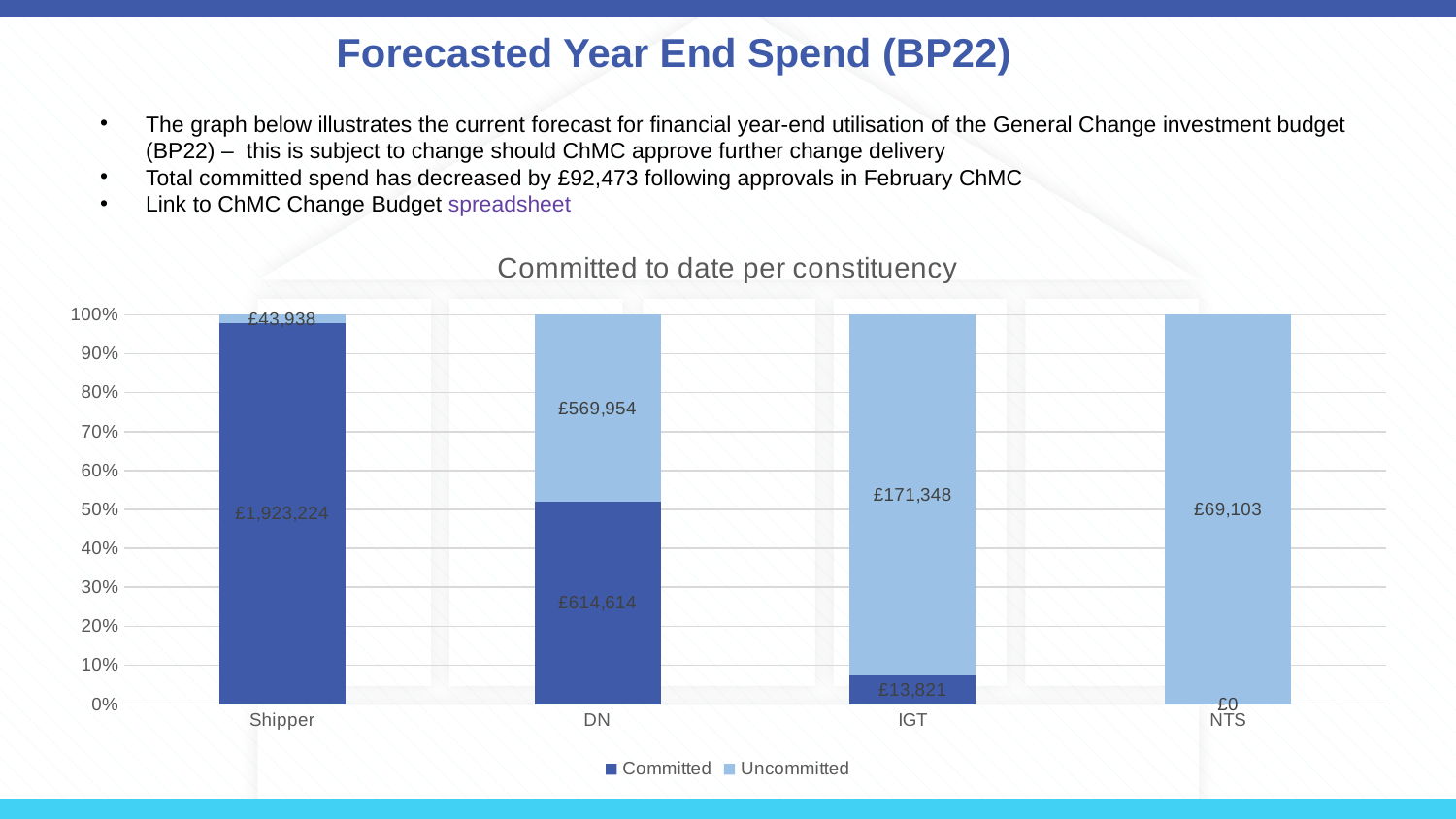
What is the total of the Committed and Uncommitted values for IGT? £185,169 Which constituency has the highest Committed value? Shipper How many series does the legend list? 2 Is the Committed share of the Shipper bar greater or less than 90%? greater What is the Uncommitted value for DN? £569,954 How many constituencies are shown on the x axis? 4 Which is larger for IGT, the Committed value or the Uncommitted value? Uncommitted What is the difference between the Committed and Uncommitted values for DN? £44,660 What is the Committed value for NTS? £0 What is the Committed value for Shipper? £1,923,224 What is the Committed value for IGT? £13,821 Which constituency has the lowest Uncommitted value? Shipper